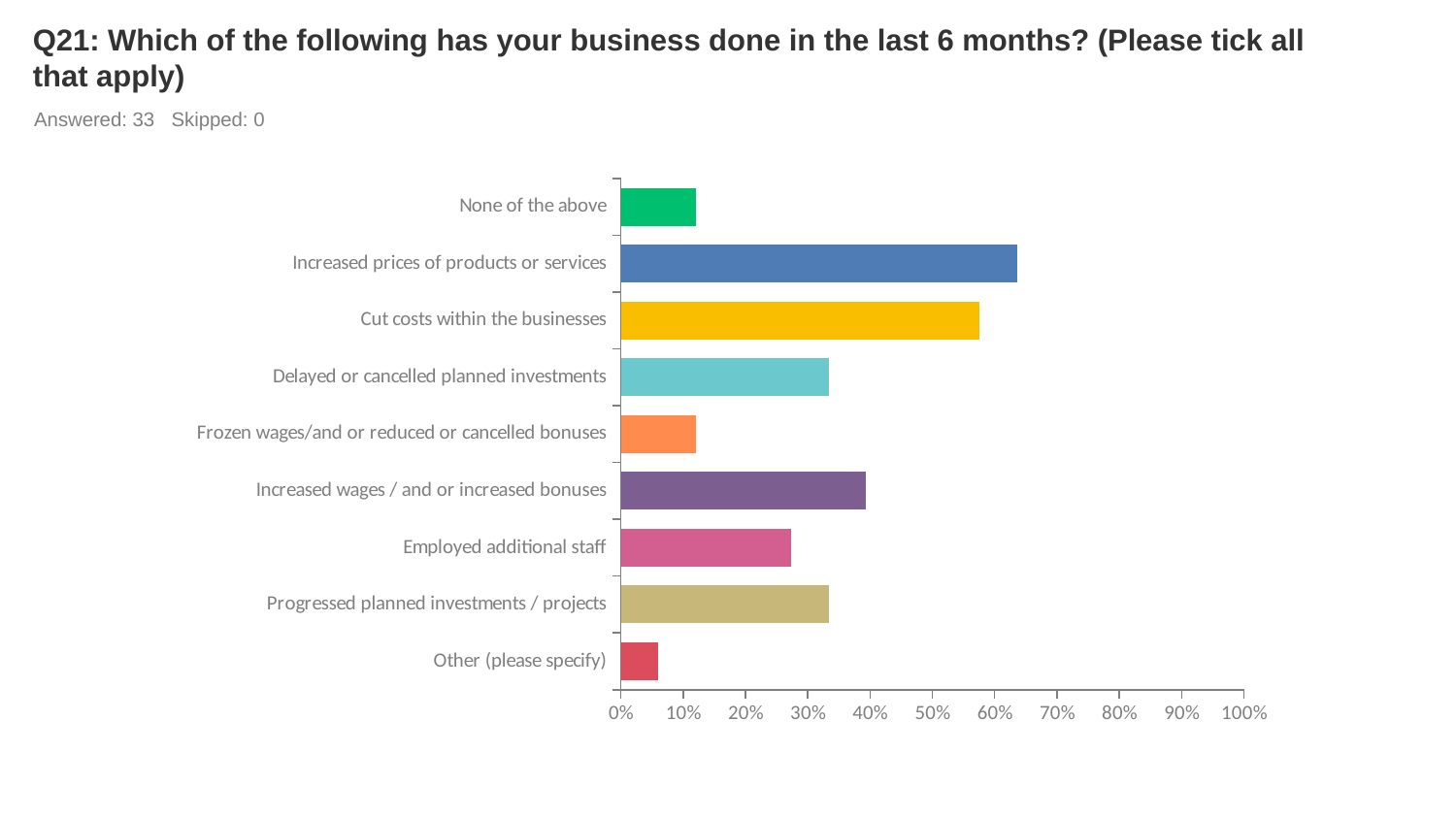
Which is larger: the value for Cut costs within the businesses or the value for Delayed or cancelled planned investments? Cut costs within the businesses How many respondents answered the question shown on the slide? 33 Is the value for Other (please specify) greater or less than 10%? less Is the value for Cut costs within the businesses greater or less than 50%? greater Is the value for Employed additional staff greater or less than 20%? greater Which is larger: the value for Increased wages / and or increased bonuses or the value for Employed additional staff? Increased wages / and or increased bonuses What kind of chart is shown on the slide? bar chart How many categories are plotted in the chart? 9 Which category has the highest value in the chart? Increased prices of products or services Which category has the lowest value in the chart? Other (please specify)